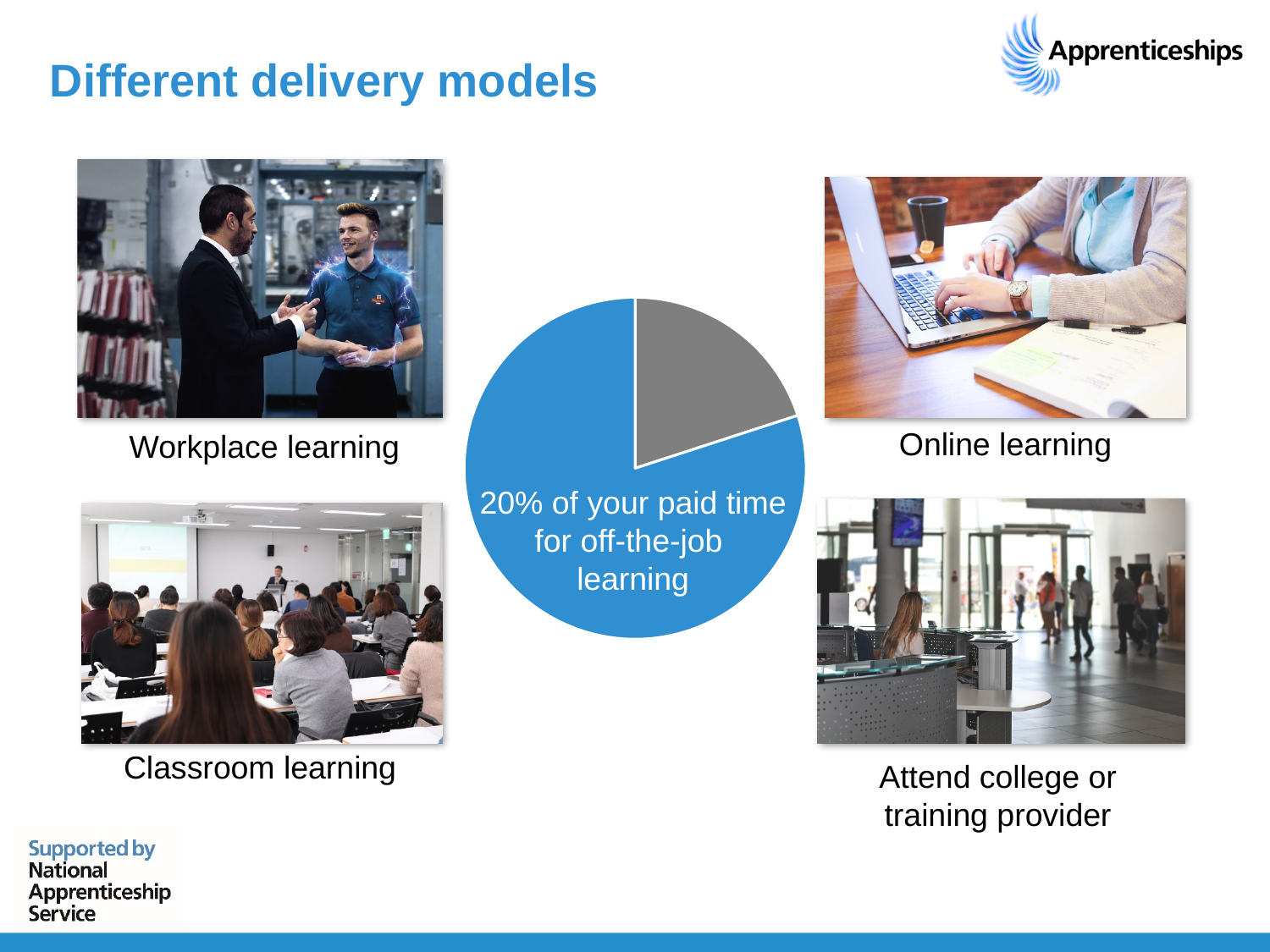
What does the 20% slice of the pie chart represent, according to the text on the chart? 20% of your paid time for off-the-job learning What colour is the larger slice of the pie chart? blue Which slice of the pie chart is the smallest? the grey slice Which slice of the pie chart is larger, the blue slice or the grey slice? the blue slice Is the share represented by the blue slice of the pie chart greater or less than 50%? greater Does the pie chart have a legend? No What share of your paid time does the pie chart show for off-the-job learning? 20% What kind of chart is shown in the centre of the slide? pie chart How many slices does the pie chart have? 2 Is the share represented by the grey slice of the pie chart greater or less than 50%? less